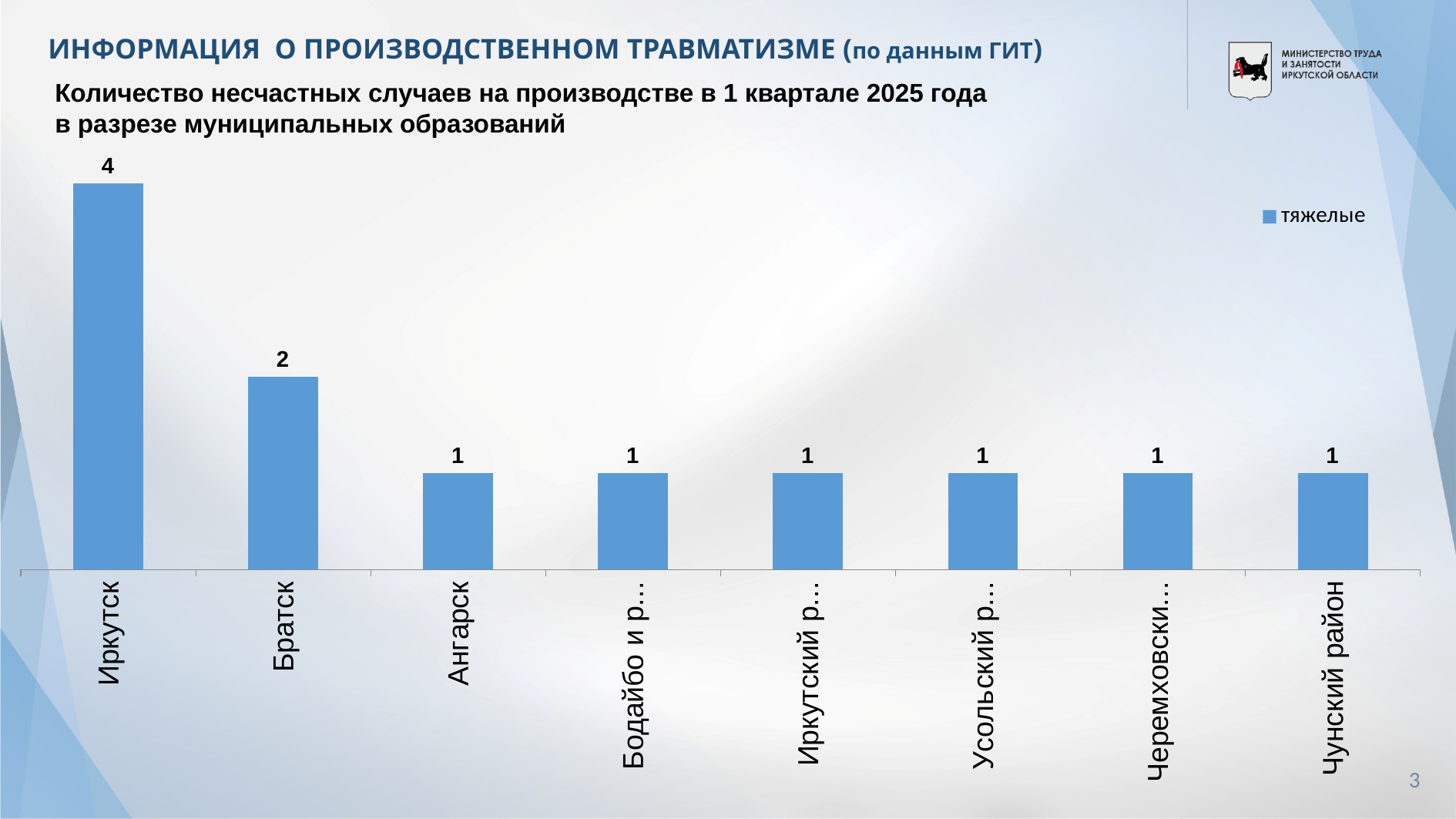
How many categories are shown on the x axis? 8 Which is larger, the value for Иркутск or the value for Братск? Иркутск What is the value for Ангарск? 1 What series name is shown in the legend? тяжелые What is the value for Чунский район? 1 What is the value for Братск? 2 Which category has the highest value? Иркутск What is the difference between the values for Иркутск and Братск? 2 What is the difference between the values for Братск and Ангарск? 1 How many series does the legend list? 1 What kind of chart is shown on the slide? bar chart What is the value for Иркутск? 4